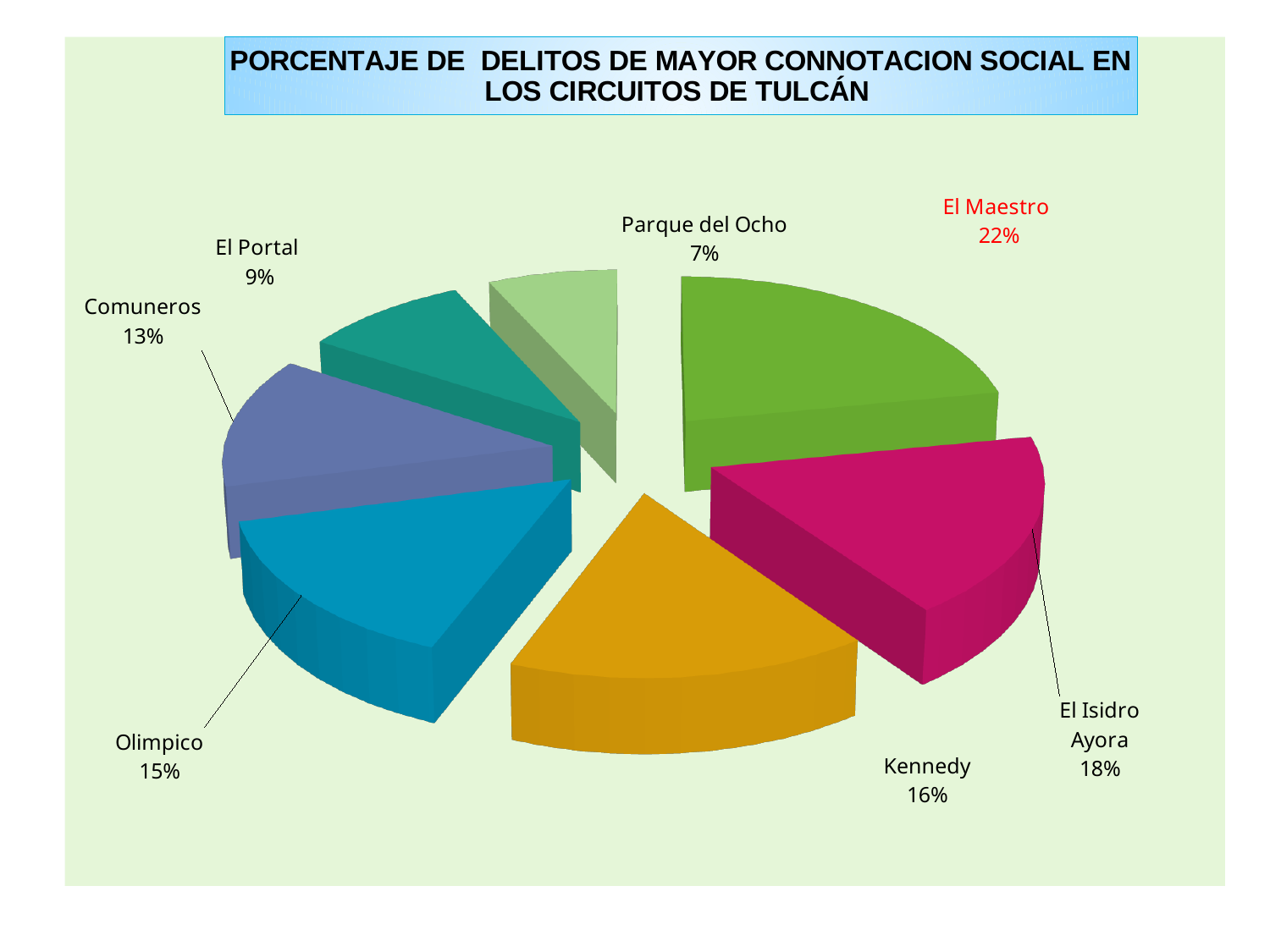
How many slices does the pie chart have? 7 What is the title of the chart? PORCENTAJE DE DELITOS DE MAYOR CONNOTACION SOCIAL EN LOS CIRCUITOS DE TULCÁN What percentage is shown for El Maestro? 22% What percentage is shown for Parque del Ocho? 7% Which circuit has the largest share of the pie? El Maestro Which has a larger share, Olimpico or El Portal? Olimpico Which circuit has the smallest share of the pie? Parque del Ocho What is the difference in percentage points between El Maestro and El Isidro Ayora? 4 What percentage is shown for Kennedy? 16% What percentage is shown for Comuneros? 13% What is the difference in percentage points between Kennedy and Comuneros? 3 What kind of chart is shown on the slide? pie chart